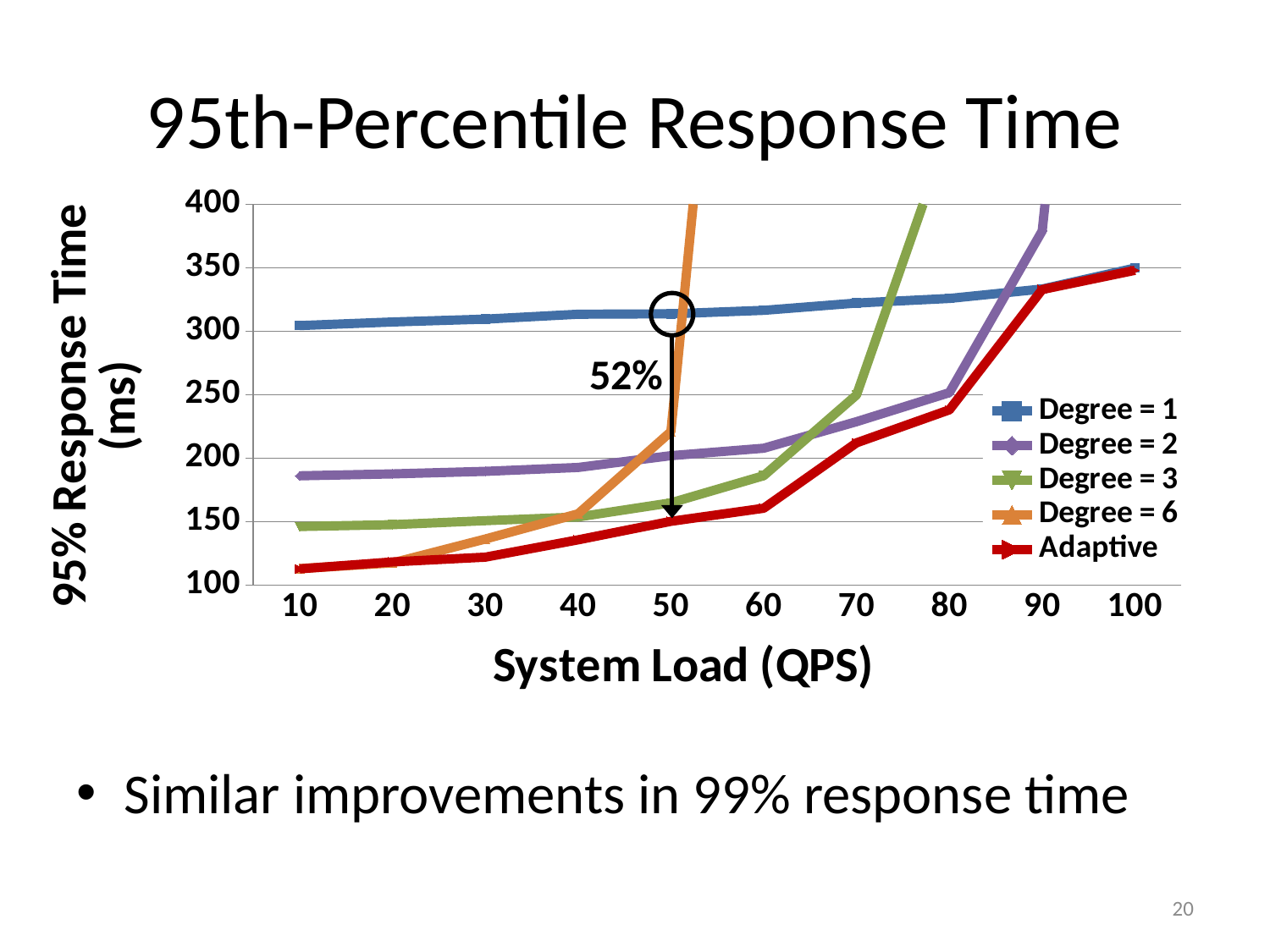
Is the value for Adaptive at 80 QPS greater or less than 250? less What kind of chart is shown on the slide? Line chart What percentage improvement is annotated on the chart at 50 QPS? 52% Is the value for Degree = 6 at 30 QPS greater or less than 150? less Does the Adaptive series rise or fall as system load increases from 10 to 100 QPS? Rises At a system load of 50 QPS, which has the larger 95% response time, Degree = 6 or Adaptive? Degree = 6 Is the value for Degree = 2 at 10 QPS greater or less than 200? less Which series has the highest 95% response time at a system load of 10 QPS? Degree = 1 How many series does the legend list? 5 How many system load values are marked on the x axis? 10